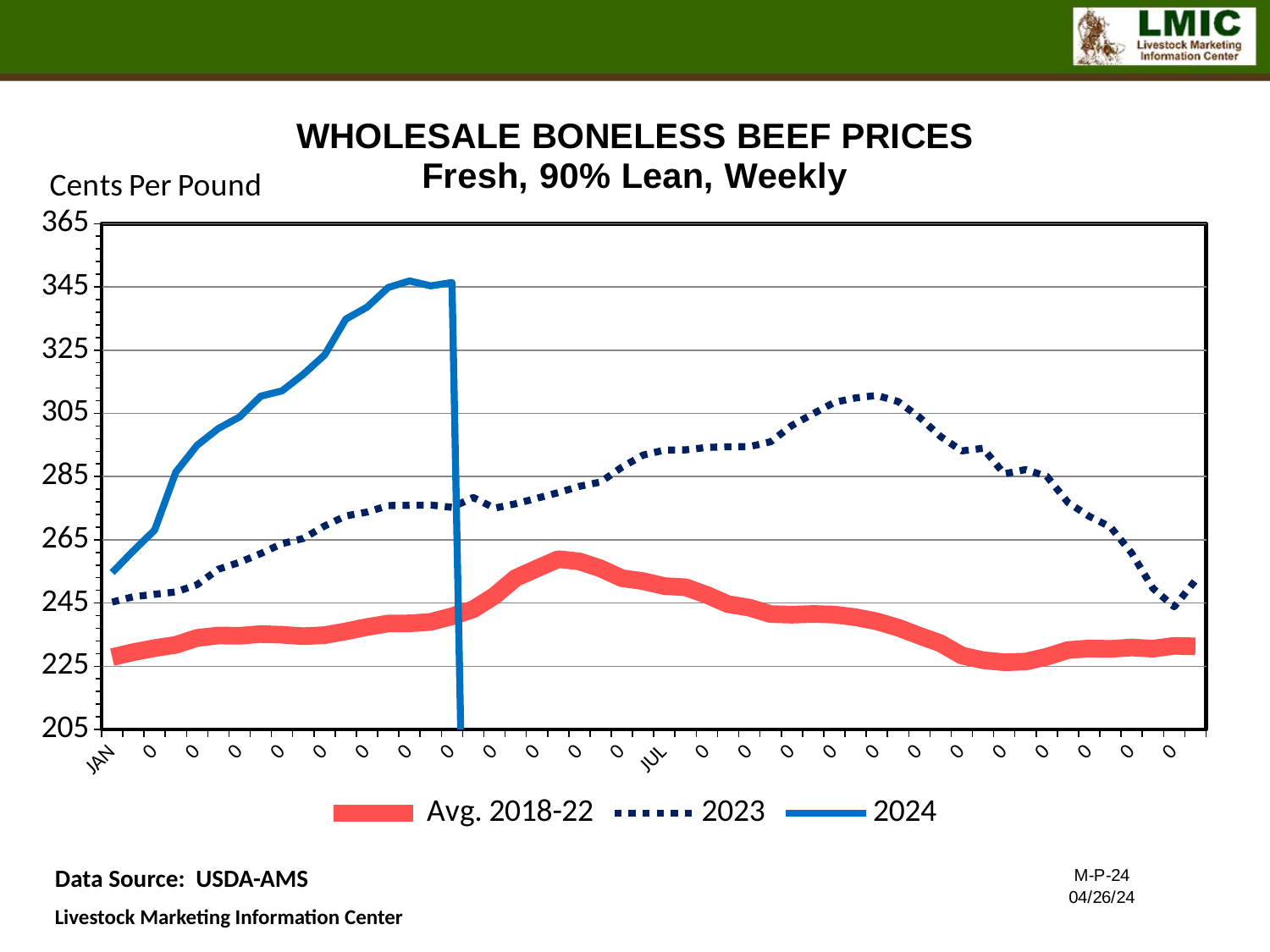
Is the value of the Avg. 2018-22 series at JAN greater or less than 245? less Is the highest value of the 2023 line greater or less than 305? greater Does the 2023 line rise or fall overall from JUL to the end of the year? fall What are the three series listed in the legend? Avg. 2018-22, 2023, 2024 What unit is shown on the y-axis label? Cents Per Pound Does the 2024 line rise or fall from JAN to its last plotted week? rise At JAN, which series has the higher value, 2024 or 2023? 2024 Is the value of the 2023 series at JAN greater or less than 265? less How many series does the legend list? 3 What kind of chart is shown on the slide? line chart Which series has the lowest values across the whole chart? Avg. 2018-22